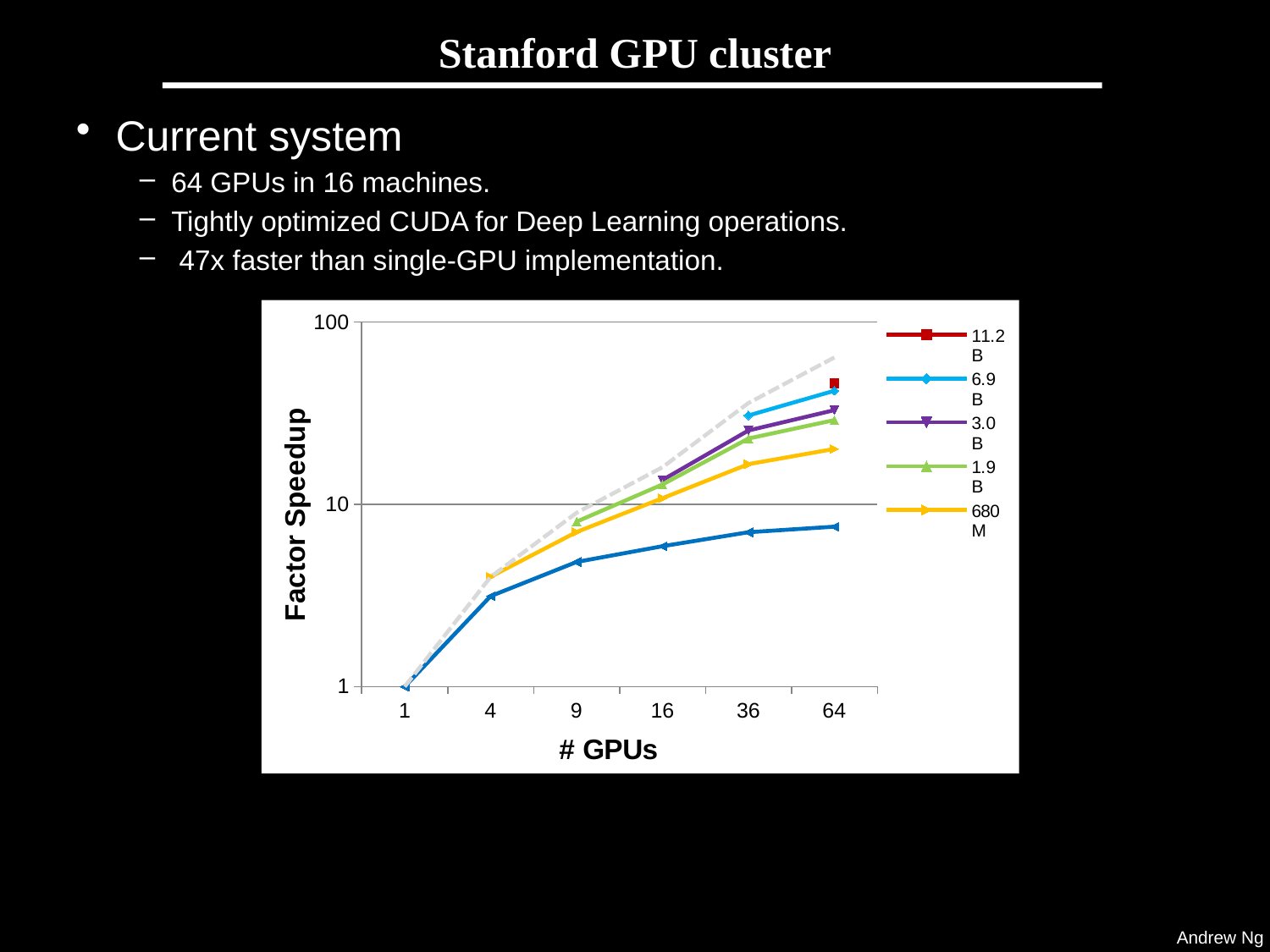
How many series does the chart legend list? 5 At 64 GPUs, which has the higher Factor Speedup: the 6.9 B series or the 680 M series? 6.9 B Does the Factor Speedup for the 6.9 B series rise or fall as the number of GPUs increases? rises What kind of chart is shown on the slide? line chart Is the Factor Speedup for the 680 M series at 64 GPUs greater or less than 10? greater How many # GPUs values are marked on the x axis of the chart? 6 Is the Factor Speedup for the 680 M series at 4 GPUs greater or less than 10? less Is the Factor Speedup for the 11.2 B series at 64 GPUs greater or less than 100? less What is the Factor Speedup at 1 GPU? 1 What is the label of the x axis of the chart? # GPUs What is the label of the y axis of the chart? Factor Speedup Among the series listed in the legend, which has the lowest Factor Speedup at 64 GPUs? 680 M